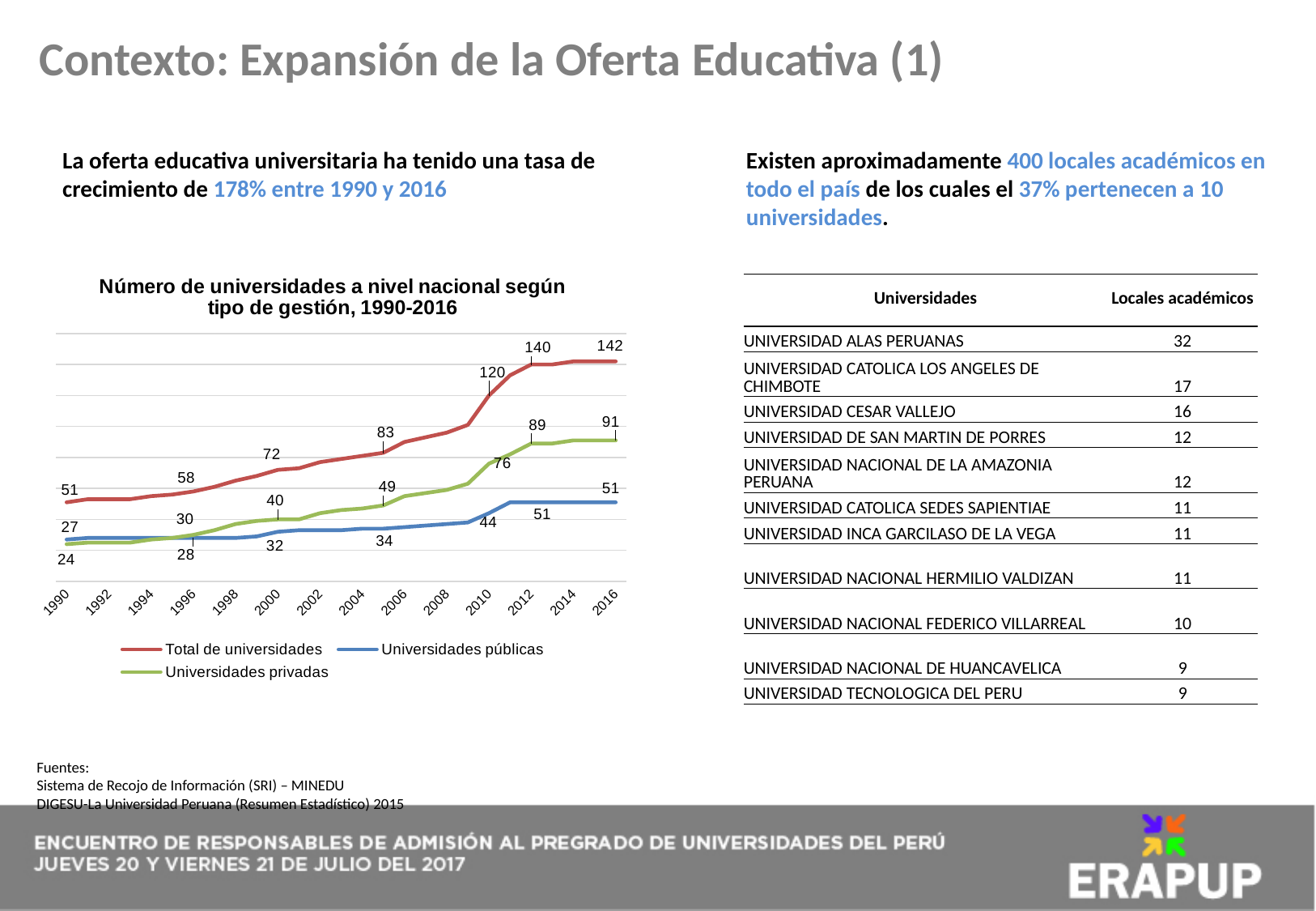
What is the difference between Universidades privadas and Universidades públicas in 2016? 40 Which series is shown in red in the chart? Total de universidades What is the total number of universities in 2016 according to the chart? 142 What is the value for Universidades privadas in 2010? 76 What is the value for Universidades públicas in 1990? 27 How many series does the legend of the chart list? 3 Does the Total de universidades series rise or fall from 1990 to 2016? rise What is the value for Universidades públicas in 2016? 51 In 2012, which is larger: Universidades privadas or Universidades públicas? Universidades privadas What kind of chart is used to show the number of universities by type of management, 1990-2016? line chart What is the value for Total de universidades in 2000? 72 By how much did the total number of universities increase from 1990 to 2016? 91